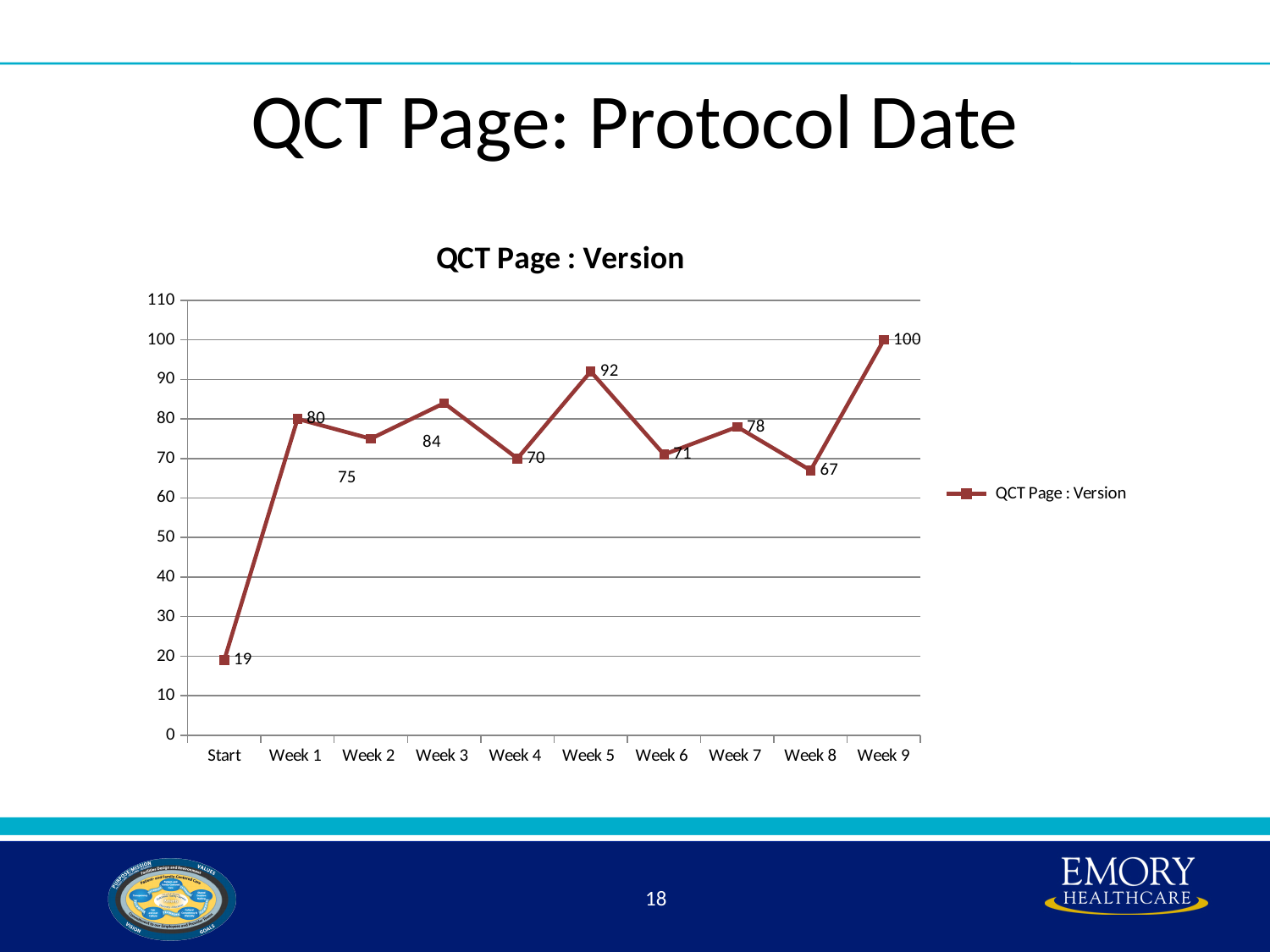
What is the title of the chart? QCT Page : Version What is the value for Week 5? 92 How many points are plotted on the line? 10 What kind of chart is shown? Line chart How many series does the legend list? 1 Which point has the highest value? Week 9 What is the difference between the values for Week 1 and Start? 61 What is the value for Week 8? 67 What is the value at Start? 19 Which is larger, the value for Week 3 or the value for Week 4? Week 3 What is the difference between the values for Week 9 and Week 8? 33 Which point has the lowest value? Start